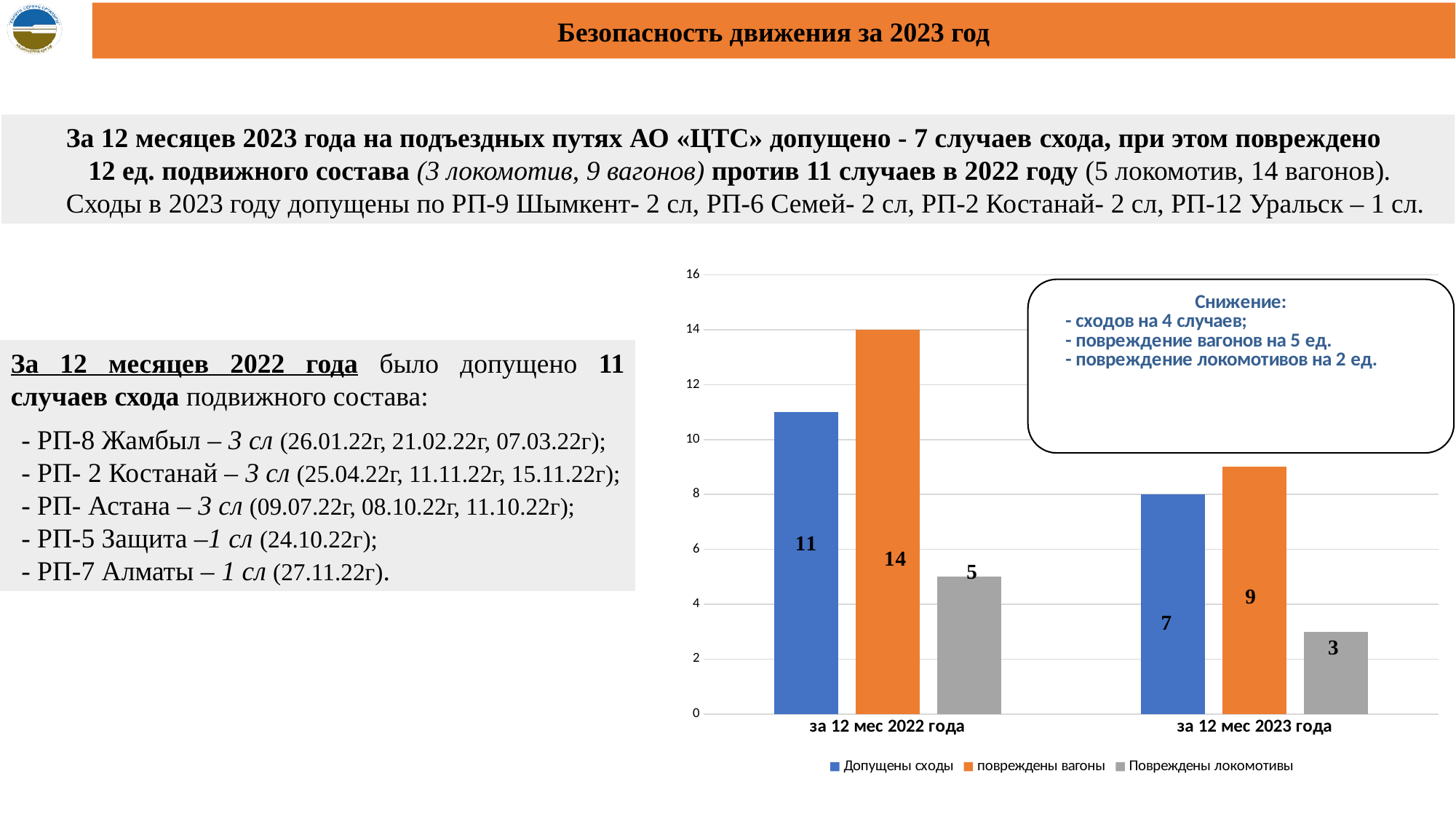
What is the difference between 'повреждены вагоны' in 2022 and in 2023? 5 What is the value of 'Допущены сходы' for 'за 12 мес 2022 года'? 11 How many categories are shown on the x axis? 2 Which series has the lowest value for 'за 12 мес 2023 года'? Повреждены локомотивы Which series has the highest value for 'за 12 мес 2022 года'? повреждены вагоны What is the value of 'повреждены вагоны' for 'за 12 мес 2023 года'? 9 What kind of chart is shown on the slide? bar chart How many series does the legend list? 3 What is the value of 'Повреждены локомотивы' for 'за 12 мес 2022 года'? 5 Which is larger: 'Допущены сходы' for 2022 or for 2023? за 12 мес 2022 года What is the value of 'Повреждены локомотивы' for 'за 12 мес 2023 года'? 3 Does the value of 'Допущены сходы' rise or fall from 2022 to 2023? fall